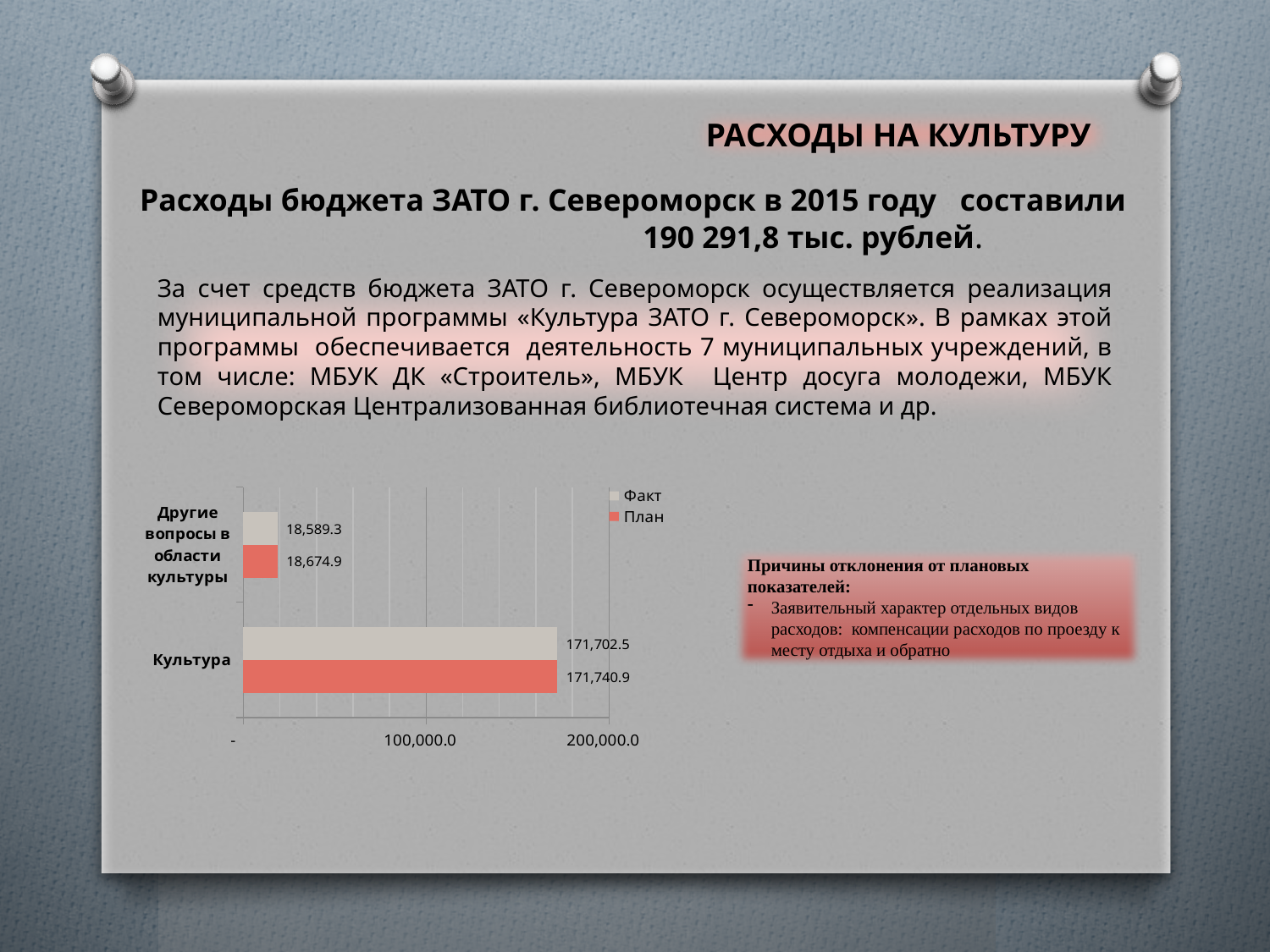
What is the Факт value for Другие вопросы в области культуры? 18,589.3 Which category has the lowest План value? Другие вопросы в области культуры What is the План value for Другие вопросы в области культуры? 18,674.9 What kind of chart is shown on the slide? bar chart What is the Факт value for Культура? 171,702.5 What is the План value for Культура? 171,740.9 What is the difference between the План and Факт values for Другие вопросы в области культуры? 85.6 Which category has the highest Факт value? Культура How many categories are shown on the chart? 2 How many series does the legend list? 2 Is the Факт value for Культура greater or less than 100,000.0? greater What is the difference between the План and Факт values for Культура? 38.4